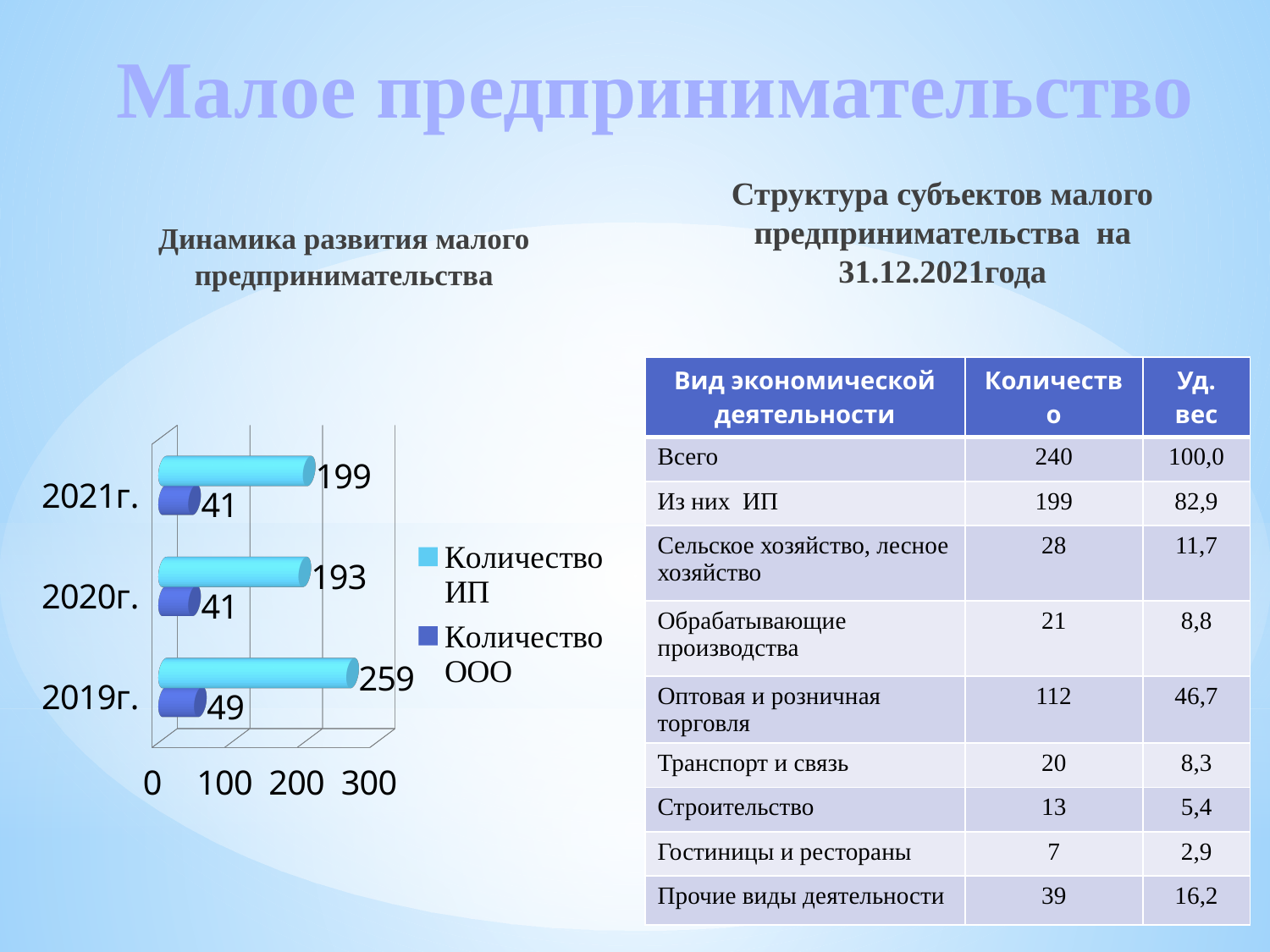
What is the difference between "Количество ООО" in 2019г. and in 2020г.? 8 How many years (categories) are shown on the chart? 3 Which year has the lowest value for "Количество ИП"? 2020г. What is the value of "Количество ИП" for 2020г.? 193 Which year has the highest value for "Количество ИП"? 2019г. Which is larger: "Количество ИП" in 2021г. or "Количество ИП" in 2020г.? 2021г. What is the value of "Количество ИП" for 2021г.? 199 Which series is shown in dark blue in the chart legend? Количество ООО What type of chart is shown under the title "Динамика развития малого предпринимательства"? bar chart What is the value of "Количество ООО" for 2019г.? 49 How many series does the chart legend list? 2 What is the difference between "Количество ИП" in 2019г. and in 2021г.? 60